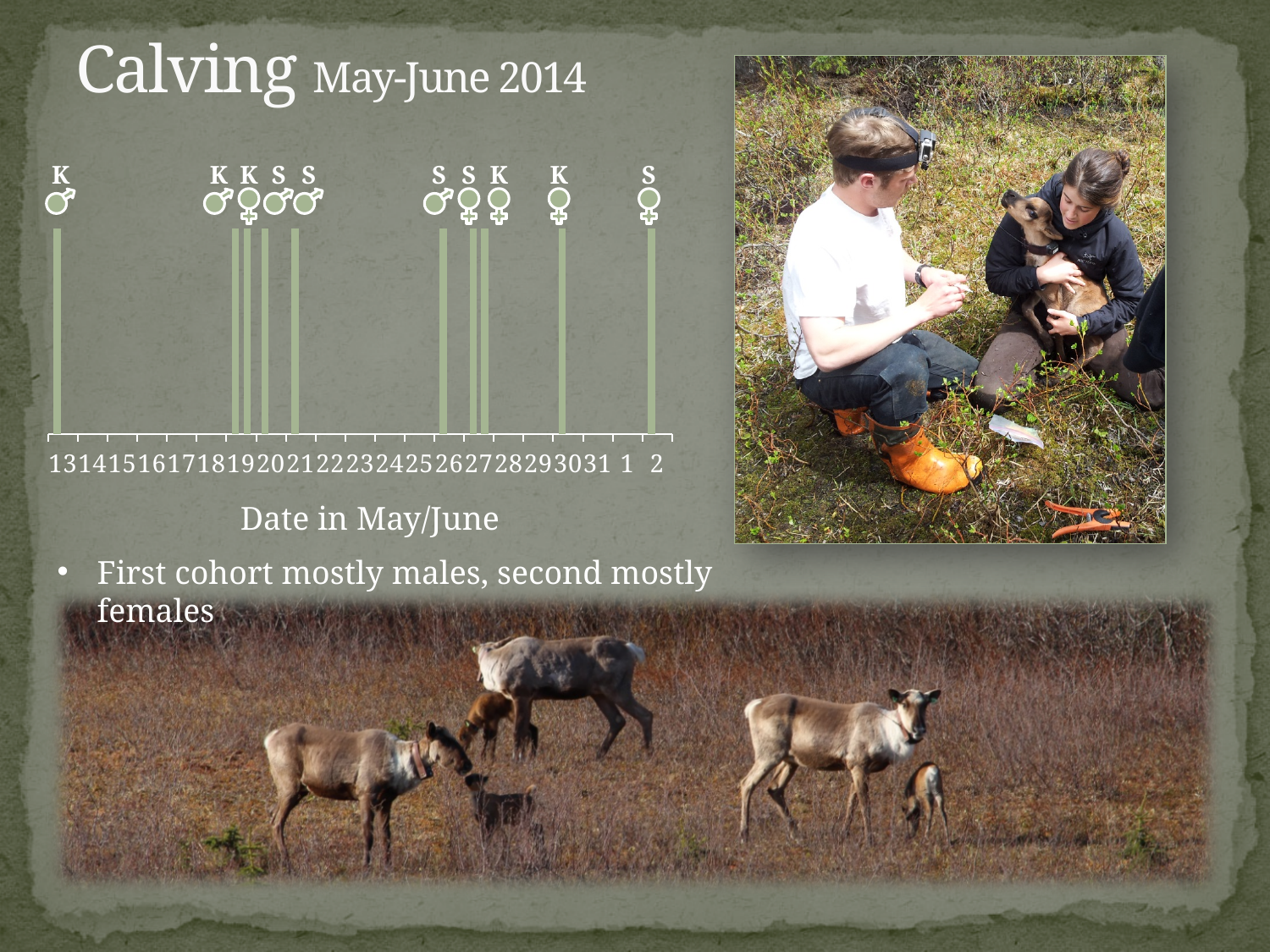
How many bars on the chart are labelled S? 5 How many bars on the chart are labelled K? 5 What letter labels the last (rightmost) bar on the chart? S How many bars are plotted on the chart? 10 What is the label on the x axis of the chart? Date in May/June What letter labels the first (leftmost) bar on the chart? K What is the earliest date on which a bar appears? 13 Which sex symbol is shown above the bar at the 13th? male What kind of chart is shown on the slide? bar chart What is the latest date on which a bar appears? 2